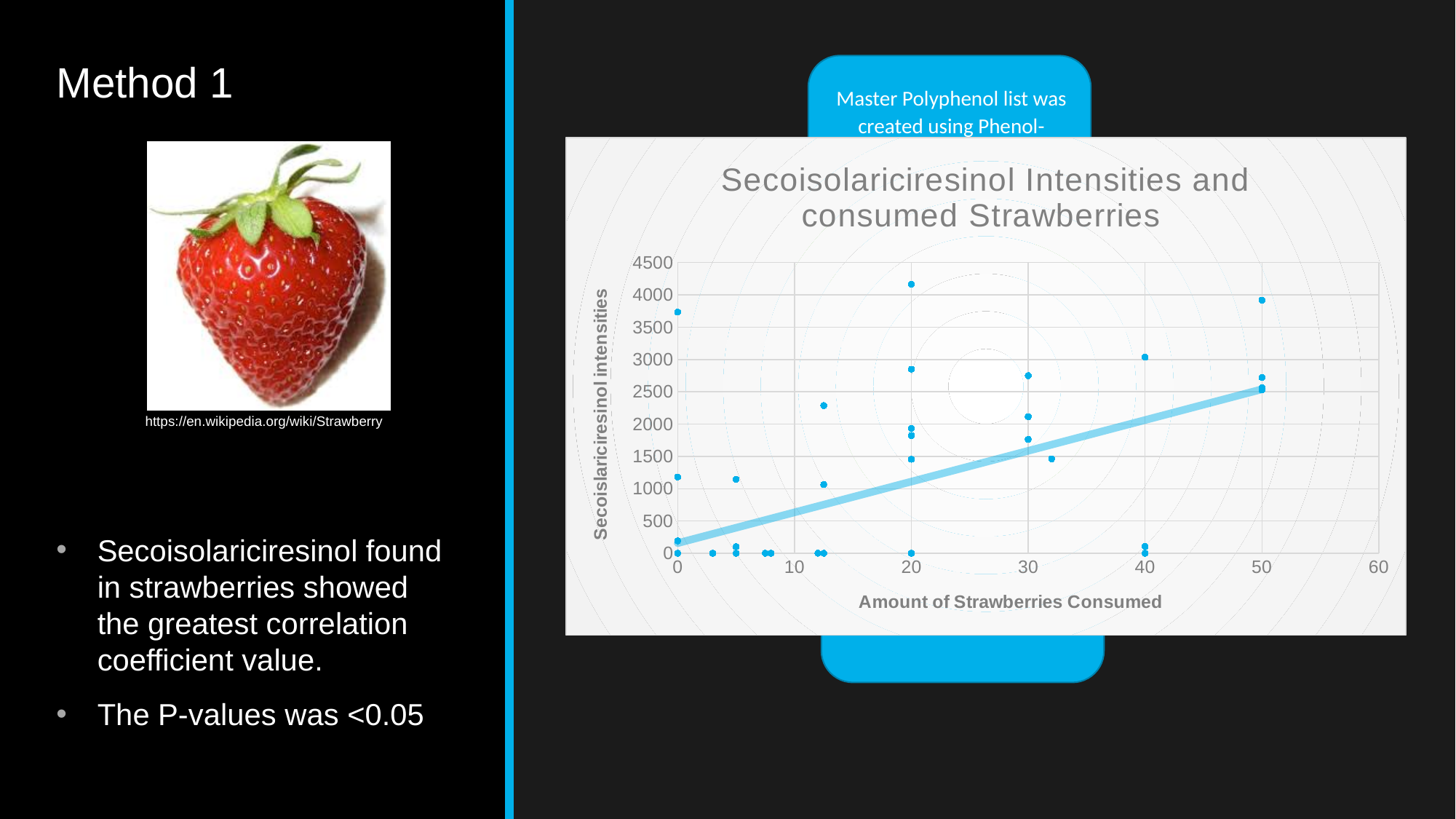
Which is higher: the highest point at 20 strawberries consumed or the highest point at 50 strawberries consumed? 20 strawberries consumed What is the title of the chart? Secoisolariciresinol Intensities and consumed Strawberries Is the point plotted at about 32 strawberries consumed greater or less than 1000 in intensity? greater What kind of chart is shown on the slide? scatter chart Does the trend line in the chart rise or fall as the amount of strawberries consumed increases? rises At which amount of strawberries consumed does the single highest intensity point in the chart occur? 20 What is the maximum value shown on the y axis of the chart? 4500 Is the highest point plotted at 20 strawberries consumed greater or less than 4000 in intensity? greater What is the label of the x axis of the chart? Amount of Strawberries Consumed Is the highest point plotted at 50 strawberries consumed greater or less than 3500 in intensity? greater